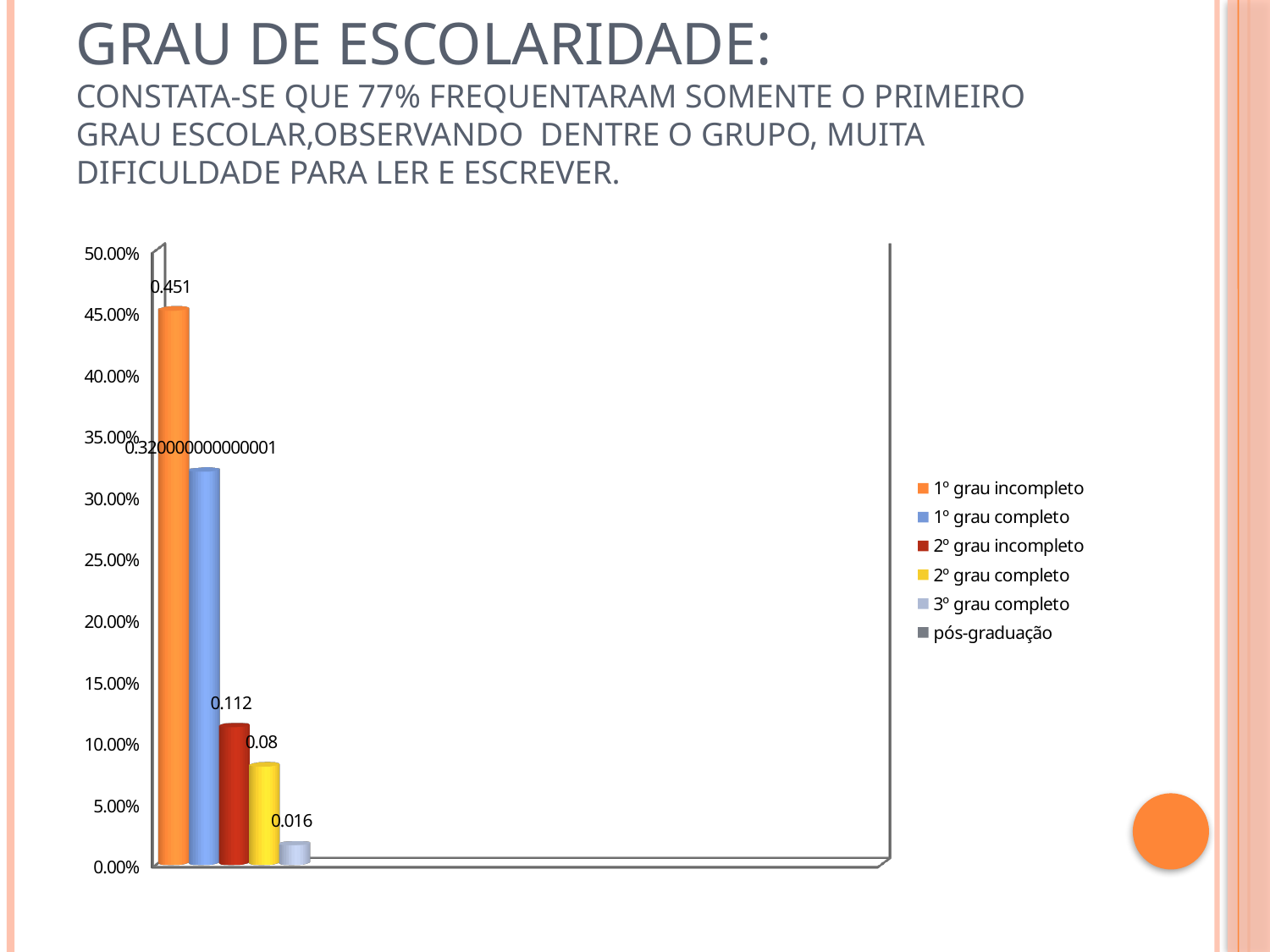
What colour is the bar for 1º grau incompleto? Orange Is the value for 1º grau completo greater or less than 30.00%? greater What is the difference between the data labels for 2º grau completo and 3º grau completo? 0.064 Which is larger, the bar for 1º grau completo or the bar for 2º grau incompleto? 1º grau completo What is the data label shown for the 1º grau incompleto series? 0.451 Which series has the highest bar in the chart? 1º grau incompleto What kind of chart is shown on the slide? Bar chart What is the difference between the data labels for 1º grau incompleto and 2º grau incompleto? 0.339 What is the data label shown for the 2º grau incompleto series? 0.112 What is the data label shown for the 2º grau completo series? 0.08 How many series does the legend list? 6 What is the data label shown for the 3º grau completo series? 0.016